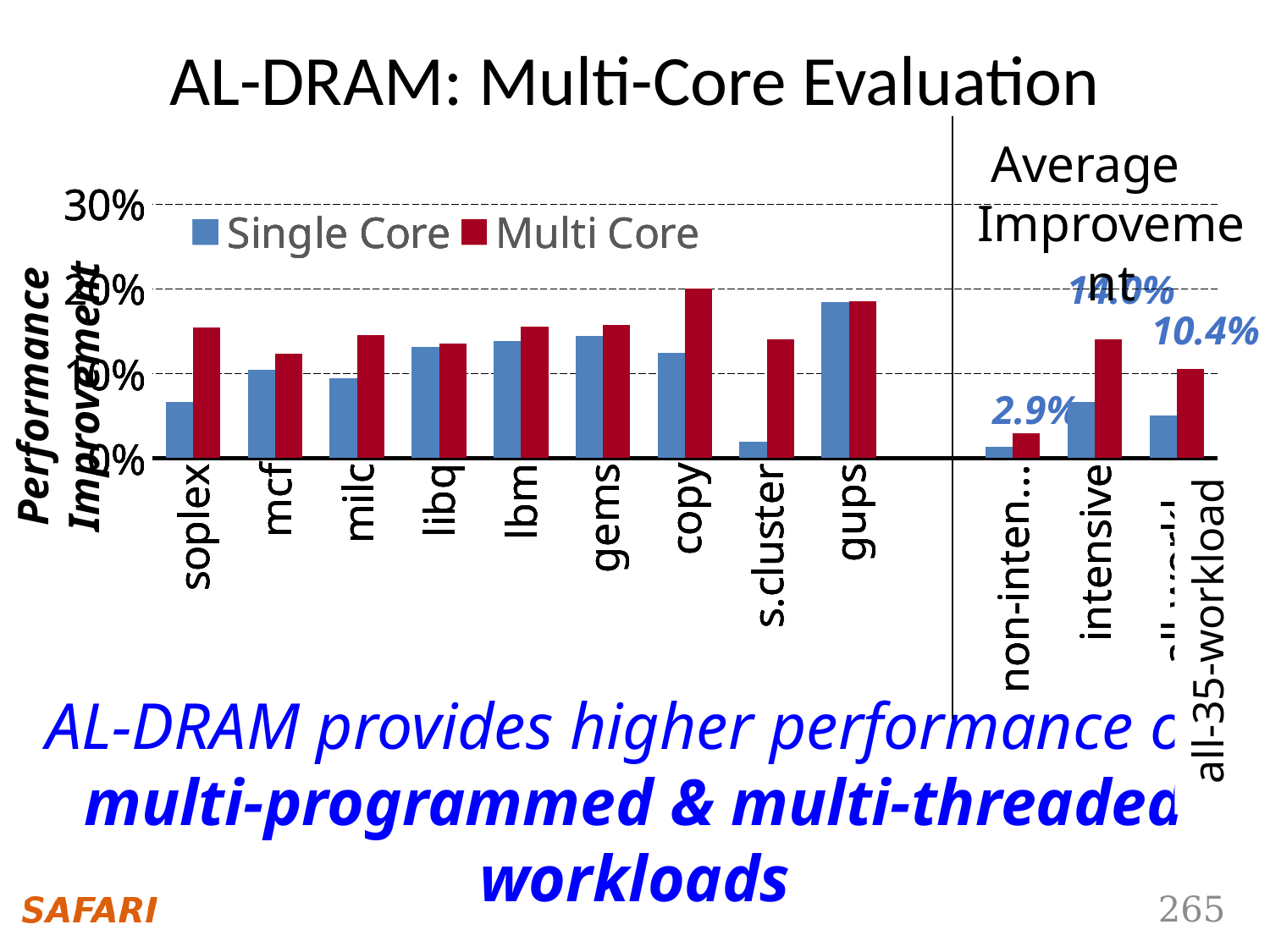
Among the nine individual benchmarks left of the divider, which has the highest Multi Core bar? copy Is the Multi Core value for copy greater or less than 10%? greater For soplex, which is larger: the Single Core value or the Multi Core value? Multi Core What is the title of the slide containing the chart? AL-DRAM: Multi-Core Evaluation How many individual benchmark categories are plotted to the left of the vertical divider line? 9 How many series does the chart legend list? 2 What is the labelled Multi Core average improvement for the all-35-workload category? 10.4% What is the labelled Multi Core average improvement for the non-intensive category? 2.9% What are the two series named in the chart legend? Single Core and Multi Core Among the nine individual benchmarks left of the divider, which has the lowest Single Core bar? s.cluster Among the nine individual benchmarks left of the divider, which has the highest Single Core bar? gups What type of chart is shown on the slide? bar chart